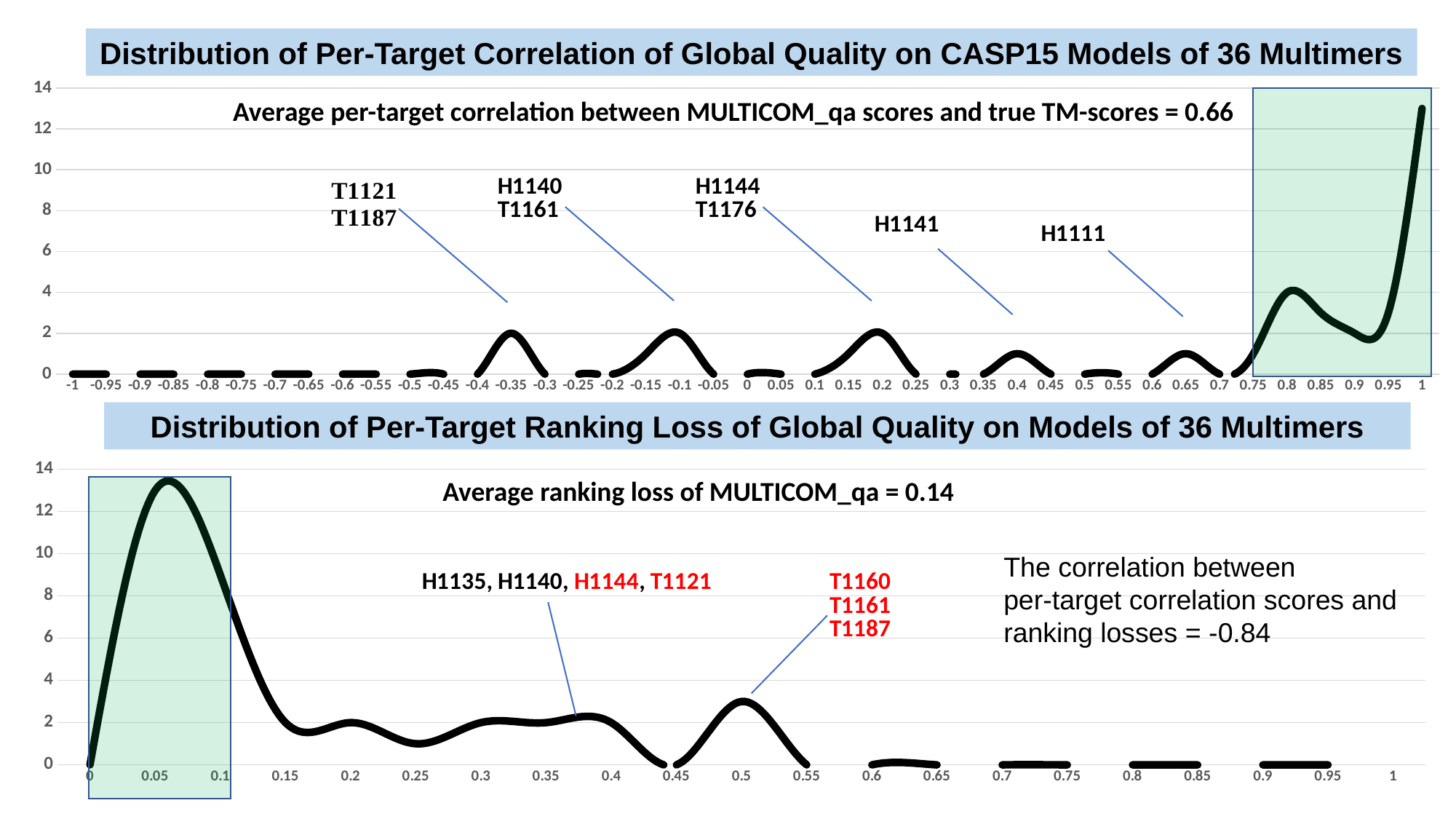
In the bottom chart (per-target ranking loss), is the value larger at x = 0.05 or at x = 0.5? 0.05 In the top chart (per-target correlation), is the value at x = -0.35 greater or less than 4? less In the top chart (per-target correlation), at which x-axis value does the curve reach its highest point? 1 In the top chart (per-target correlation), does the curve rise or fall between x = 0.9 and x = 1? rise In the top chart (per-target correlation), is the value at x = 0.8 greater or less than 2? greater According to the text on the bottom chart, what is the average ranking loss of MULTICOM_qa? 0.14 In the top chart (per-target correlation), is the value larger at x = 0.8 or at x = -0.35? 0.8 In the top chart (per-target correlation), is the value at x = 1 greater or less than 10? greater What kind of chart is the top chart, 'Distribution of Per-Target Correlation of Global Quality on CASP15 Models of 36 Multimers'? line chart According to the text on the top chart, what is the average per-target correlation between MULTICOM_qa scores and true TM-scores? 0.66